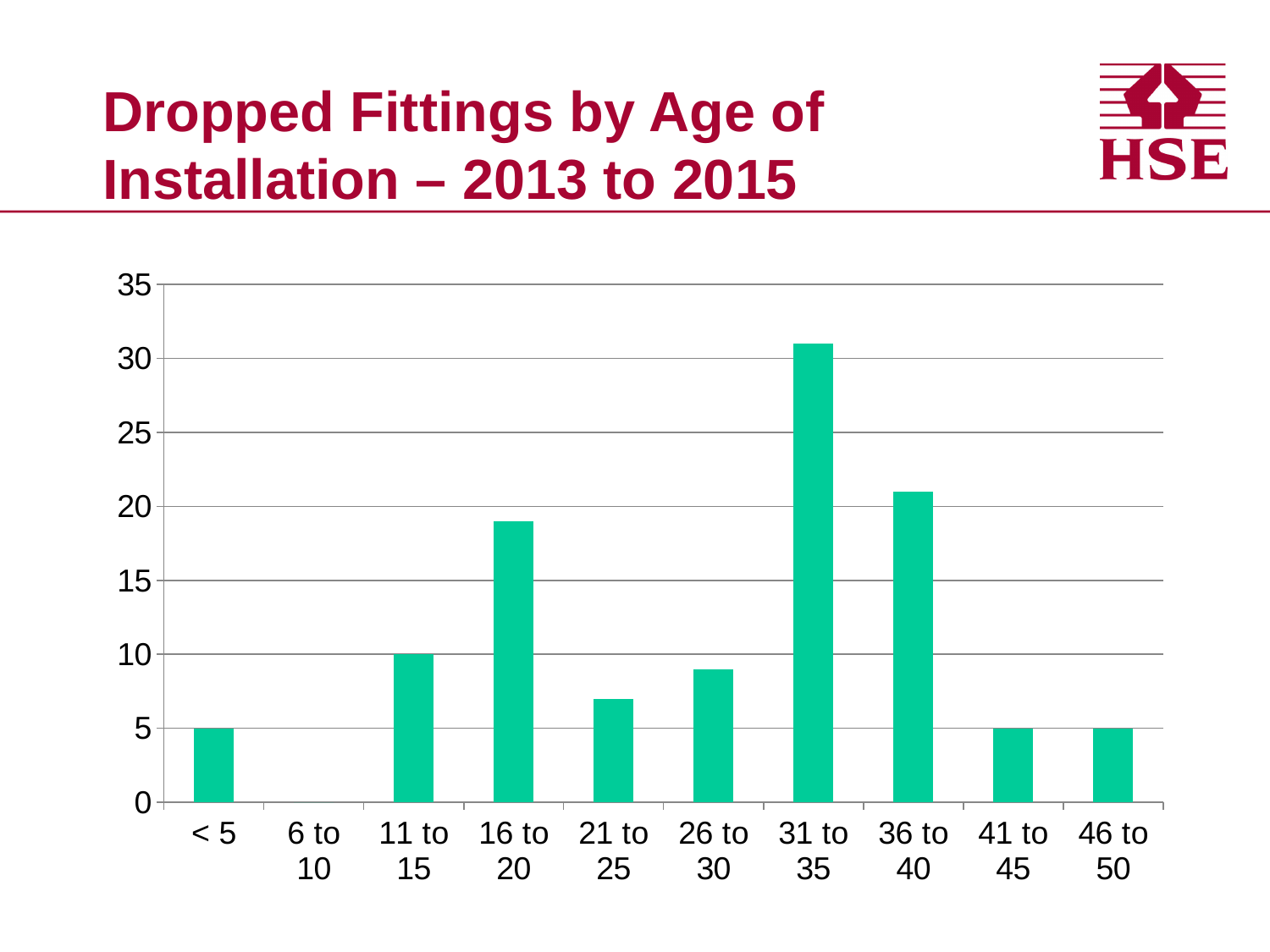
What kind of chart is shown on the slide? bar chart How many age-of-installation categories are shown on the x axis? 10 Is the value for '31 to 35' greater or less than 30? greater What is the value for the '11 to 15' category? 10 Which age category has the lowest number of dropped fittings? 6 to 10 What is the difference between the values for '11 to 15' and '< 5'? 5 Which age category has the highest number of dropped fittings? 31 to 35 Is the value for '16 to 20' greater or less than 20? less Which has the larger value, '31 to 35' or '36 to 40'? 31 to 35 What is the value for the '46 to 50' category? 5 What is the title of the chart on the slide? Dropped Fittings by Age of Installation – 2013 to 2015 What is the value for the '< 5' category? 5